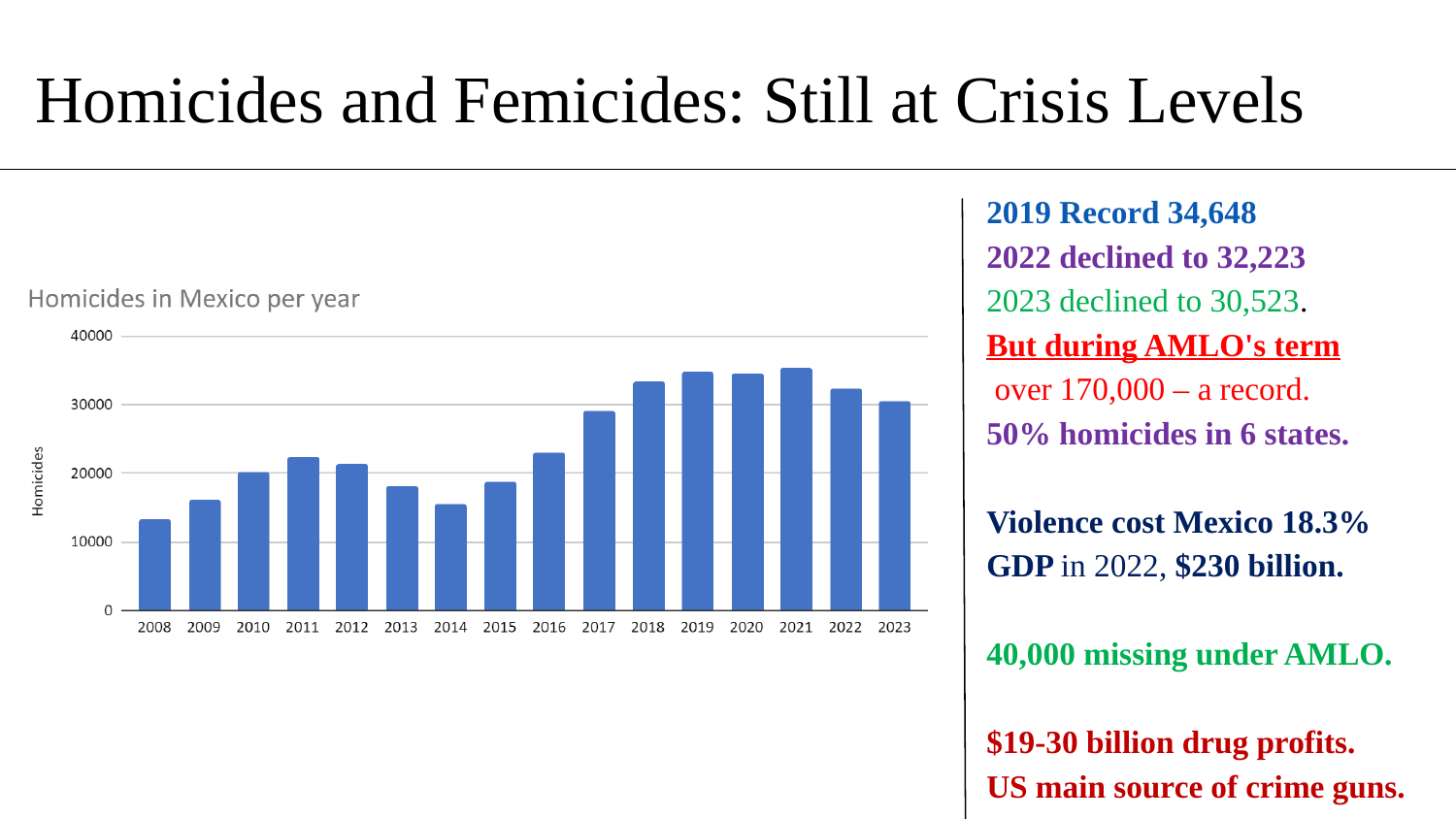
Is the value for 2018 greater or less than 30000? greater Is the value for 2014 greater or less than 20000? less Which year has the lowest number of homicides on the chart? 2008 Is the value for 2022 greater or less than 30000? greater Which year has more homicides, 2022 or 2023? 2022 How many years are plotted on the chart? 16 What kind of chart is shown on the slide? bar chart What is the title of the chart? Homicides in Mexico per year Which year has more homicides, 2018 or 2008? 2018 Do the values rise or fall from 2014 to 2021? rise